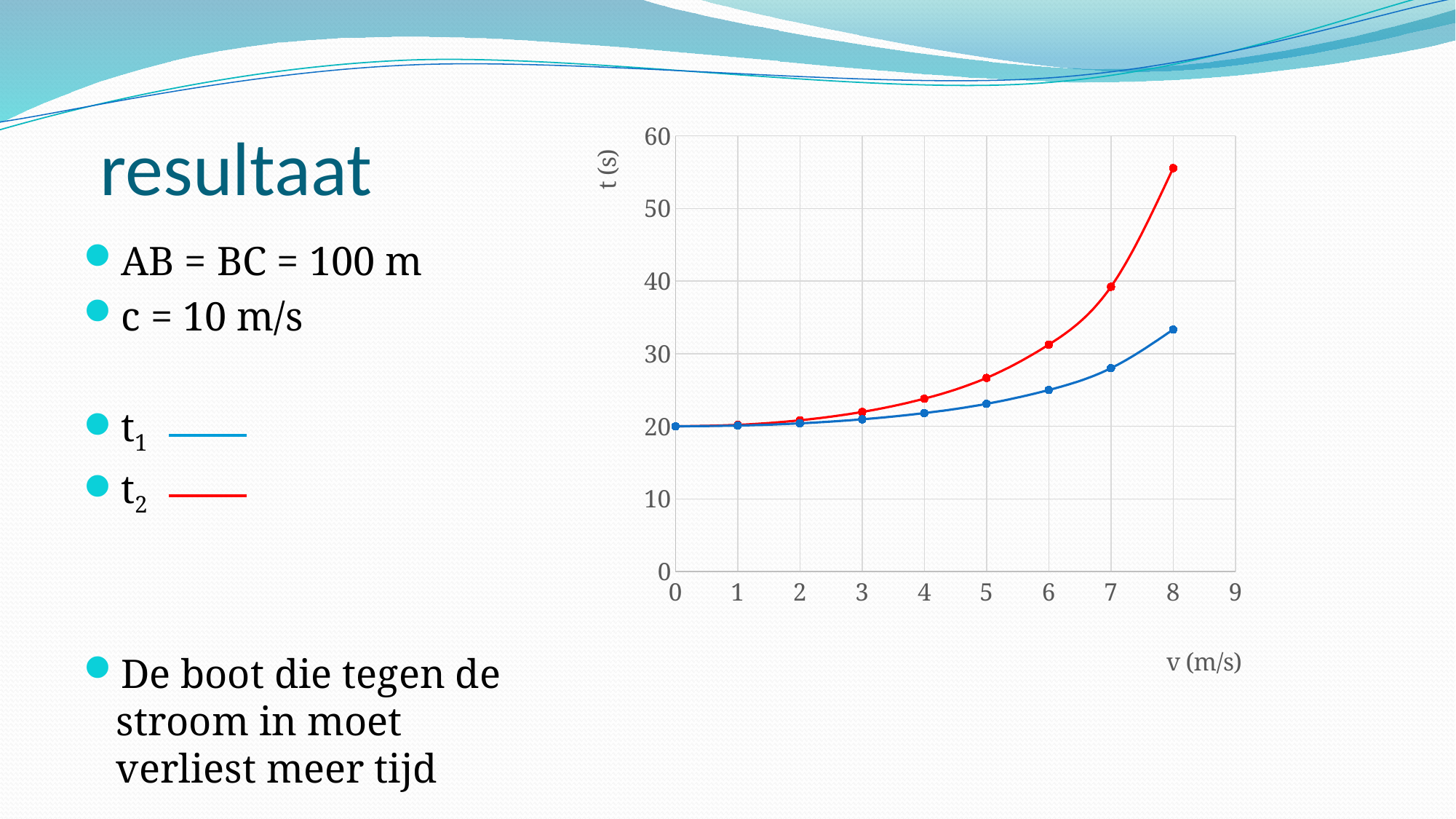
Is the value of t2 at v = 5 m/s greater or less than 30? less Which colour is used for the t2 series? red Is the value of t2 at v = 8 m/s greater or less than 50? greater How many data points does the t1 series have? 9 At v = 8 m/s, which series has the larger value, t1 or t2? t2 How many series are plotted in the chart? 2 Is the value of t1 at v = 8 m/s greater or less than 30? greater What is the value of t1 at v = 0 m/s? 20 Do the values of t2 rise or fall as v increases? rise What kind of chart is shown on the slide? line chart What is the value of t2 at v = 0 m/s? 20